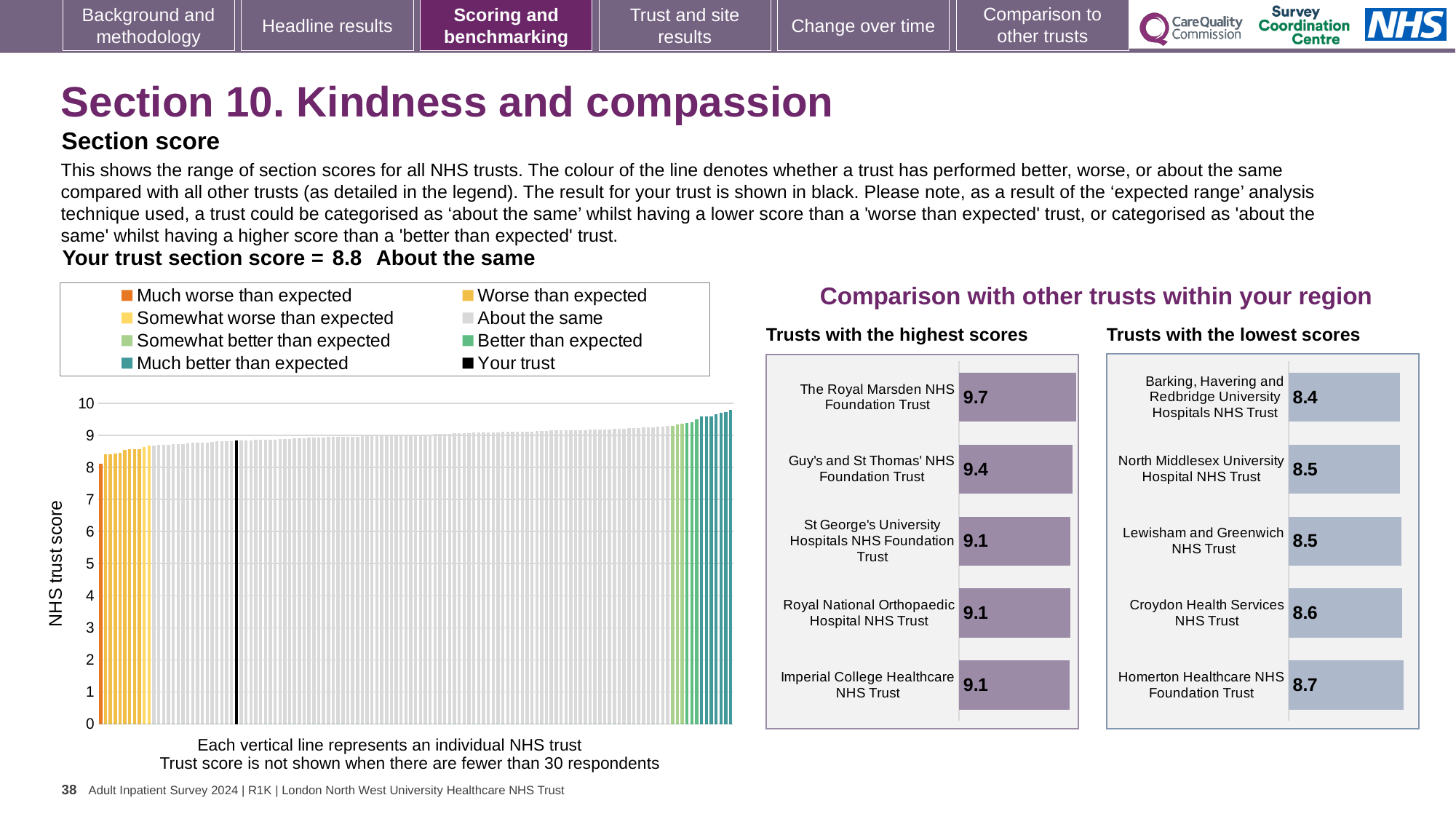
In the large chart on the left showing all NHS trusts, do the bar values rise or fall from left to right? Rise In the 'Trusts with the lowest scores' chart, which trust has the lowest score? Barking, Havering and Redbridge University Hospitals NHS Trust In the 'Trusts with the highest scores' chart, what is the score for The Royal Marsden NHS Foundation Trust? 9.7 In the 'Trusts with the lowest scores' chart, which trust has the highest score? Homerton Healthcare NHS Foundation Trust In the large chart on the left showing all NHS trusts, is the value for the black 'Your trust' bar greater or less than 8? greater In the 'Trusts with the highest scores' chart, how many trusts are shown? 5 In the 'Trusts with the highest scores' chart, what is the difference between the scores of The Royal Marsden NHS Foundation Trust and Guy's and St Thomas' NHS Foundation Trust? 0.3 What kind of chart is the large chart on the left showing all NHS trusts? Bar chart In the large chart on the left showing all NHS trusts, how many entries does the legend list? 8 In the 'Trusts with the lowest scores' chart, which has the larger score: Croydon Health Services NHS Trust or Barking, Havering and Redbridge University Hospitals NHS Trust? Croydon Health Services NHS Trust In the 'Trusts with the lowest scores' chart, what is the score for Croydon Health Services NHS Trust? 8.6 In the 'Trusts with the highest scores' chart, which trust has the highest score? The Royal Marsden NHS Foundation Trust